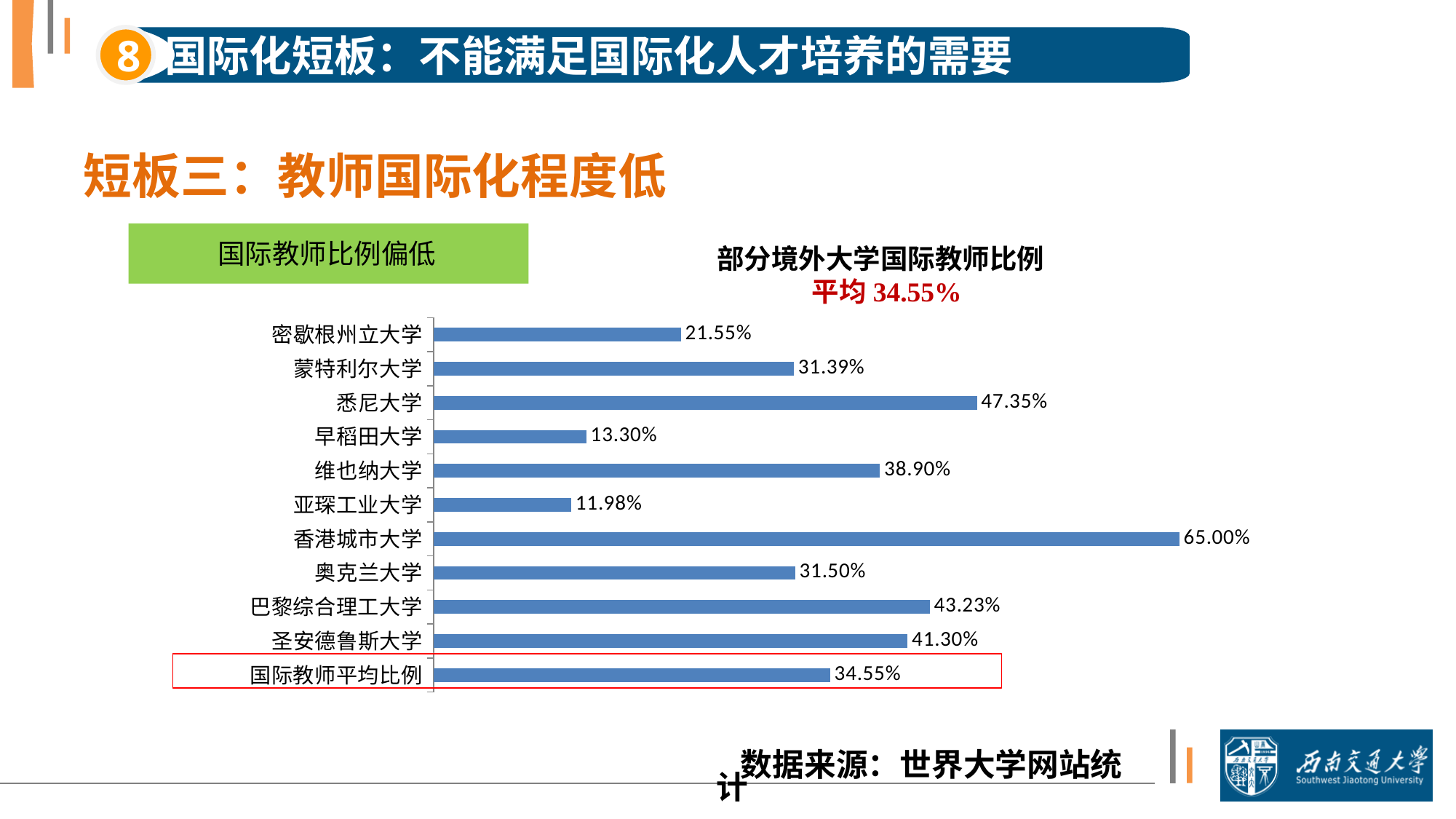
How many bars are plotted in the chart? 11 What is the difference between the values for 悉尼大学 and 密歇根州立大学? 25.80% What is the difference between the values for 香港城市大学 and 亚琛工业大学? 53.02% Which university has the lowest international faculty ratio in the chart? 亚琛工业大学 Which has a larger value, 悉尼大学 or 巴黎综合理工大学? 悉尼大学 What is the title of the chart? 部分境外大学国际教师比例 What value is shown for 圣安德鲁斯大学? 41.30% What value is shown for 早稻田大学? 13.30% What is the value labelled for 国际教师平均比例? 34.55% Which university has the highest international faculty ratio in the chart? 香港城市大学 What is the international faculty ratio shown for 香港城市大学? 65.00% What type of chart is shown on the slide? Bar chart